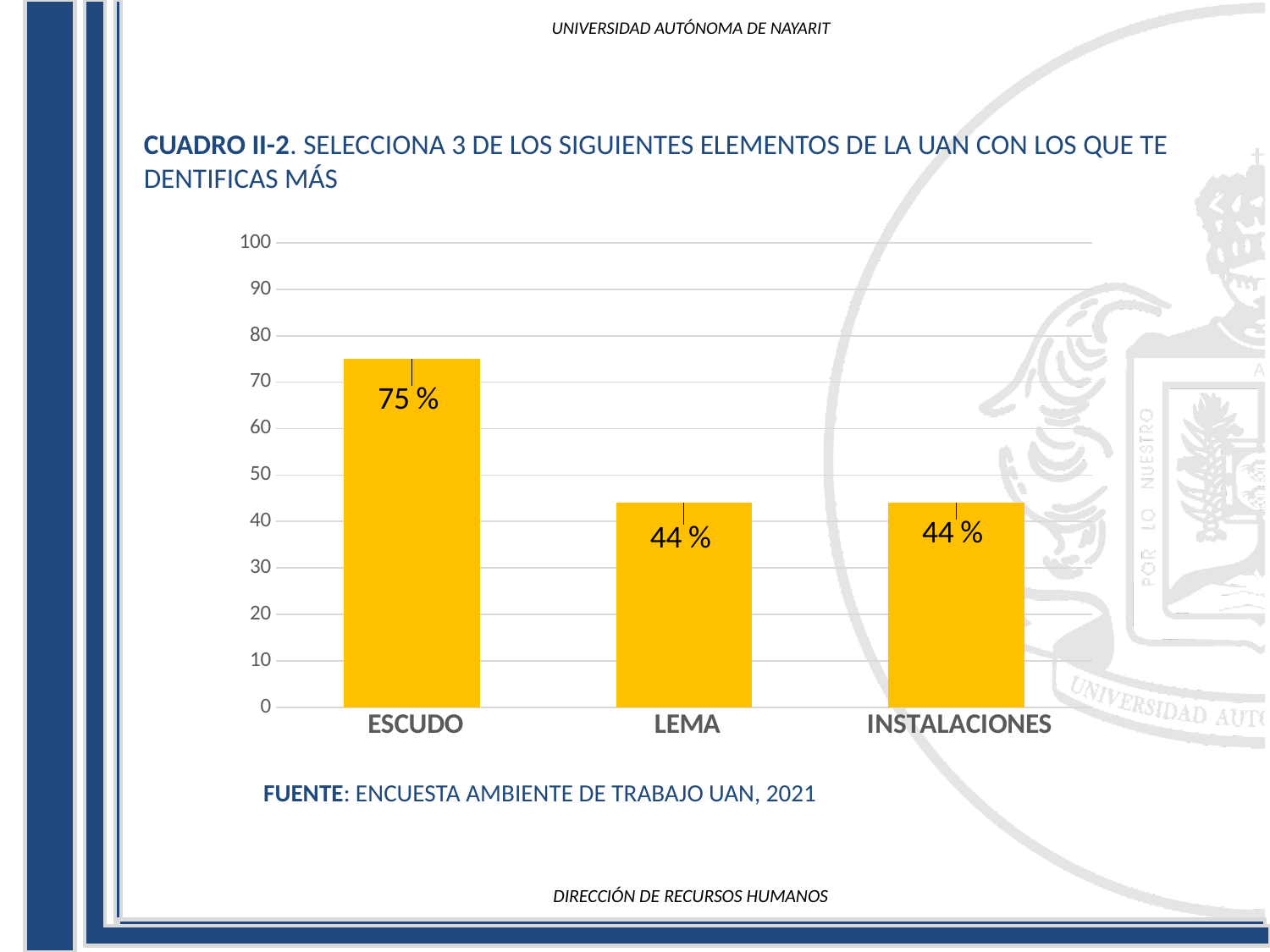
Which is larger, the value for ESCUDO or the value for INSTALACIONES? ESCUDO What kind of chart is shown on the slide? bar chart What is the value for INSTALACIONES? 44 % What source is cited below the chart? ENCUESTA AMBIENTE DE TRABAJO UAN, 2021 Which category has the highest value? ESCUDO What is the value for LEMA? 44 % What is the value for ESCUDO? 75 % What is the difference between the values for ESCUDO and LEMA? 31 % What is the maximum value shown on the y axis? 100 How many categories are shown on the x axis? 3 Is the value for LEMA greater or less than 50? less Is the value for ESCUDO greater or less than 70? greater